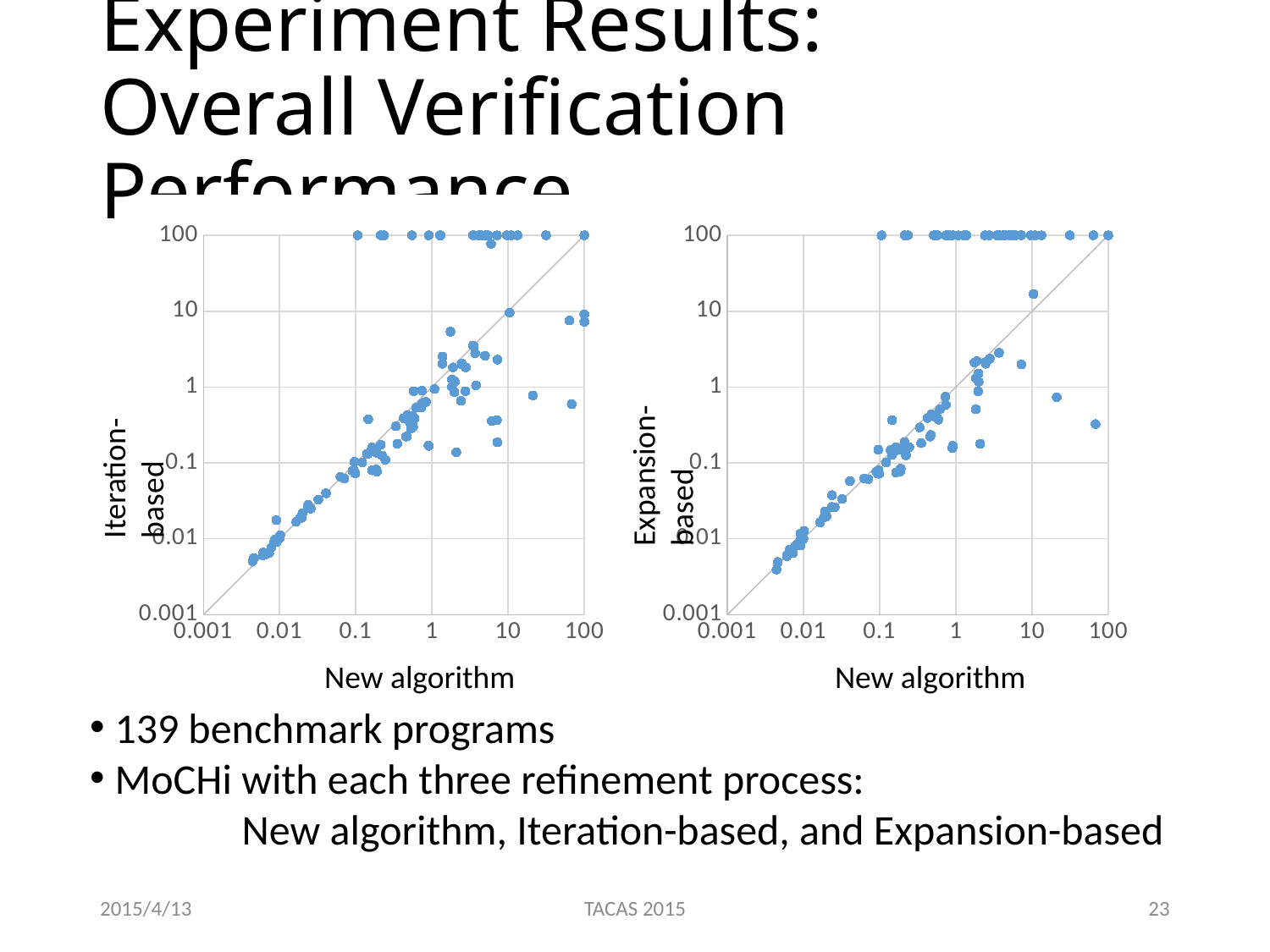
In the right chart, what is the lowest value shown on the x axis? 0.001 In the left chart, is the lowest y value reached by any point greater or less than 0.01? less In the left chart, do the plotted points generally rise or fall as the x-axis value increases? rise In the left chart, what is the highest value shown on the y axis? 100 What kind of chart is the left chart on the slide? scatter plot In the right chart, is the highest y value reached by any point greater or less than 10? greater How many charts are shown on the slide? 2 What kind of chart is the right chart on the slide? scatter plot What is the y-axis label of the right chart? Expansion-based What is the x-axis label of the left chart? New algorithm In the right chart, do the plotted points generally rise or fall as the x-axis value increases? rise